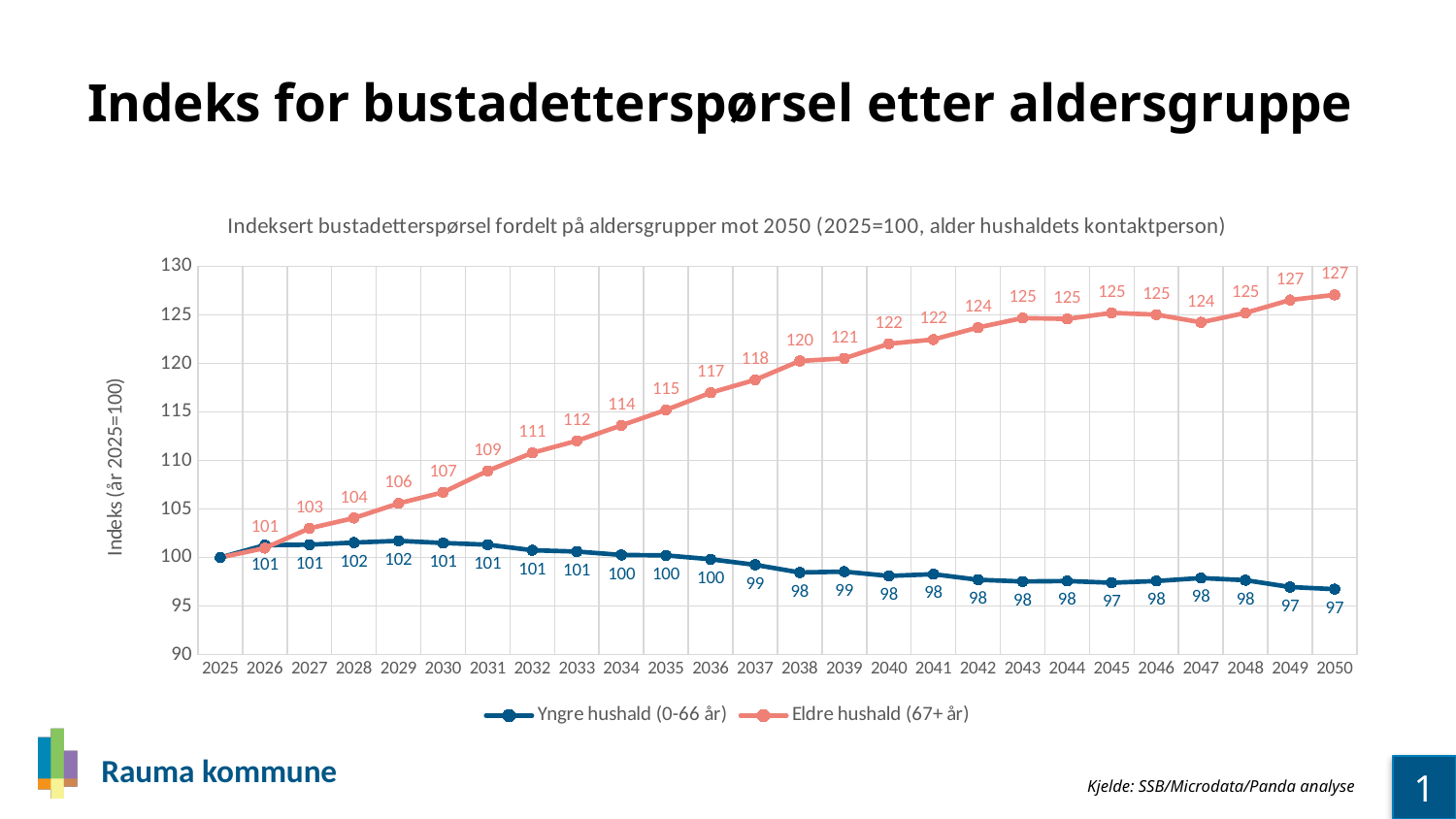
Which series has the higher value in 2038, Yngre hushald (0-66 år) or Eldre hushald (67+ år)? Eldre hushald (67+ år) Does the Eldre hushald (67+ år) series generally rise or fall from 2025 to 2050? Rise How many series does the legend list? 2 What is the value for Eldre hushald (67+ år) in 2050? 127 How many years are shown on the x axis? 26 What is the value for Yngre hushald (0-66 år) in 2029? 102 What is the value for Yngre hushald (0-66 år) in 2040? 98 What is the value for Eldre hushald (67+ år) in 2035? 115 What is the difference between Eldre hushald (67+ år) and Yngre hushald (0-66 år) in 2050? 30 In which year does Eldre hushald (67+ år) first reach 120? 2038 What is the label of the y axis? Indeks (år 2025=100) What kind of chart is shown on the slide? Line chart